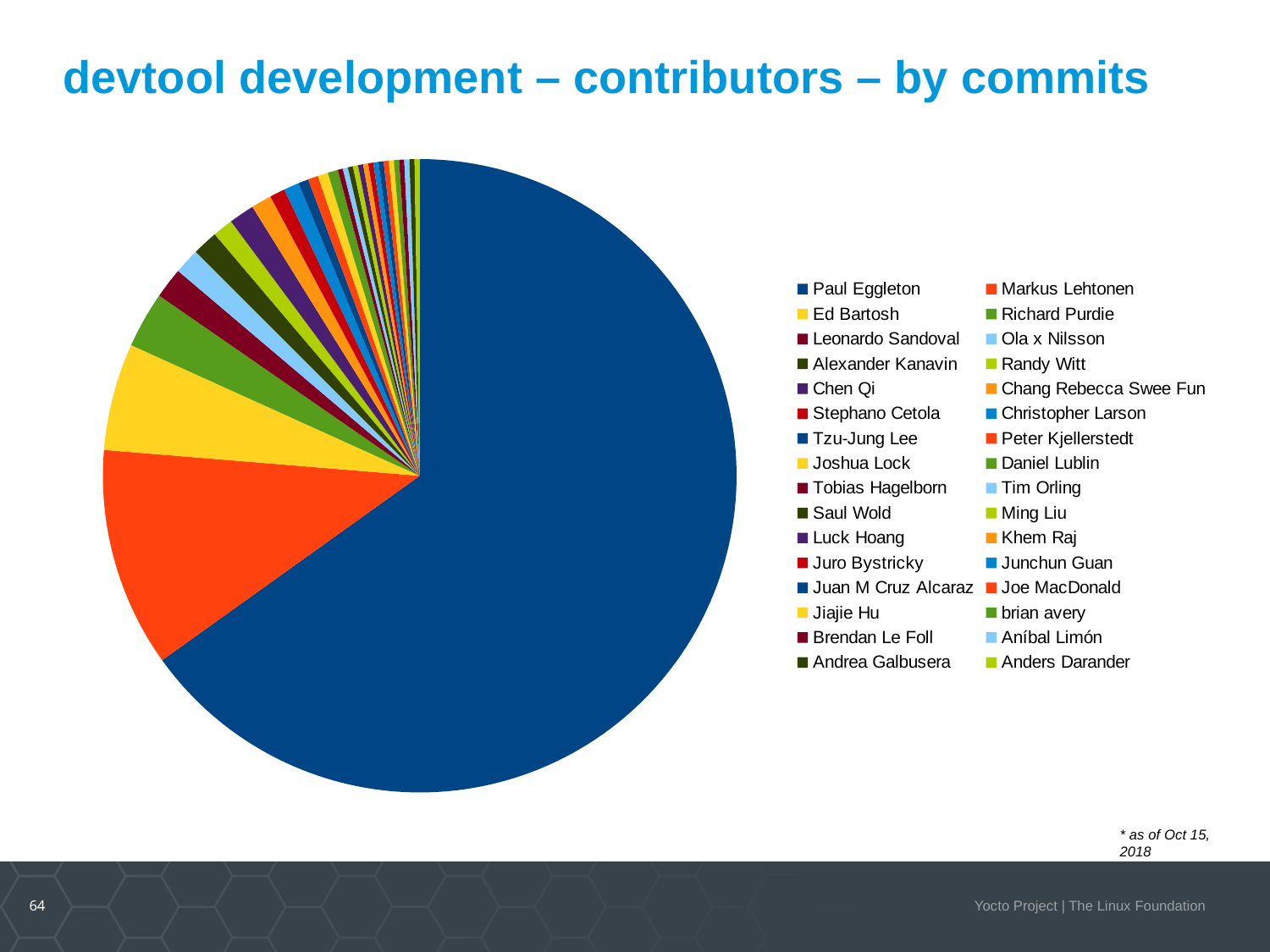
Is Paul Eggleton's slice greater or less than half of the pie? greater What kind of chart is shown on the slide? pie chart Which contributor has the largest slice of the pie? Paul Eggleton Which contributor has the second-largest slice of the pie? Markus Lehtonen Which slice is larger, Richard Purdie's or Leonardo Sandoval's? Richard Purdie Which slice is larger, Markus Lehtonen's or Ed Bartosh's? Markus Lehtonen Which slice is larger, Ed Bartosh's or Richard Purdie's? Ed Bartosh What is the title of the slide containing the chart? devtool development – contributors – by commits Which contributor is listed first in the legend of the pie chart? Paul Eggleton How many contributors are listed in the legend of the pie chart? 32